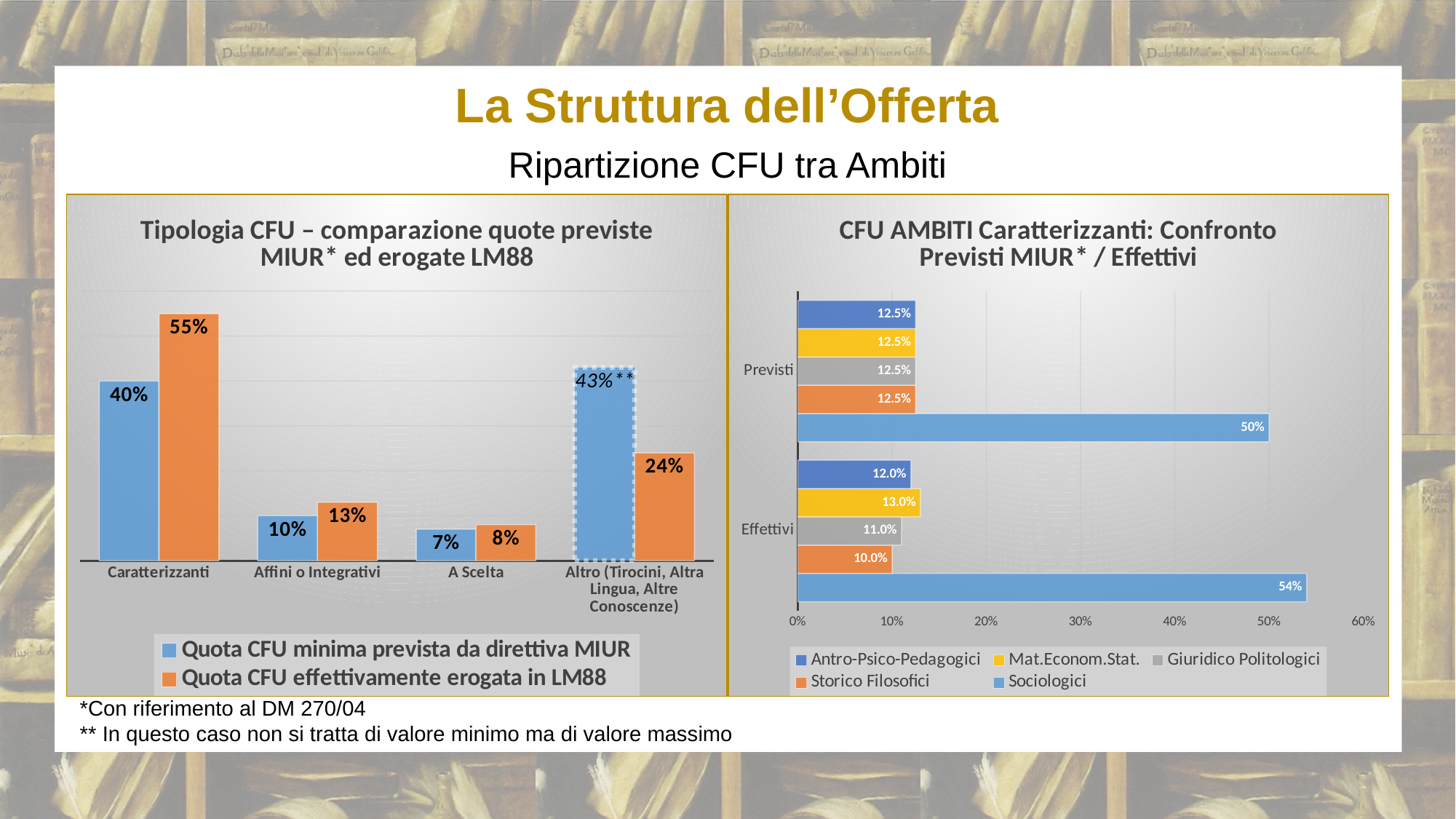
In the left chart (Tipologia CFU), which is larger for Altro (Tirocini, Altra Lingua, Altre Conoscenze): the MIUR quota or the LM88 quota? The MIUR quota (43%) In the left chart (Tipologia CFU), what is the difference between the MIUR minimum quota and the LM88 quota for Caratterizzanti? 15% In the left chart (Tipologia CFU), what is the value of 'Quota CFU minima prevista da direttiva MIUR' for A Scelta? 7% In the right chart (CFU AMBITI Caratterizzanti), what is the Effettivi value for Sociologici? 54% In the left chart (Tipologia CFU), which category has the lowest 'Quota CFU effettivamente erogata in LM88'? A Scelta In the left chart (Tipologia CFU), what is the value of 'Quota CFU effettivamente erogata in LM88' for Caratterizzanti? 55% In the left chart (Tipologia CFU), how many categories are shown on the x axis? 4 In the right chart (CFU AMBITI Caratterizzanti), what is the Effettivi value for Storico Filosofici? 10.0% What kind of chart is the right chart (CFU AMBITI Caratterizzanti)? Horizontal bar chart In the right chart (CFU AMBITI Caratterizzanti), what is the difference between the Effettivi and Previsti values for Sociologici? 4% In the right chart (CFU AMBITI Caratterizzanti), what is the Previsti value for Mat.Econom.Stat.? 12.5% In the right chart (CFU AMBITI Caratterizzanti), how many series does the legend list? 5